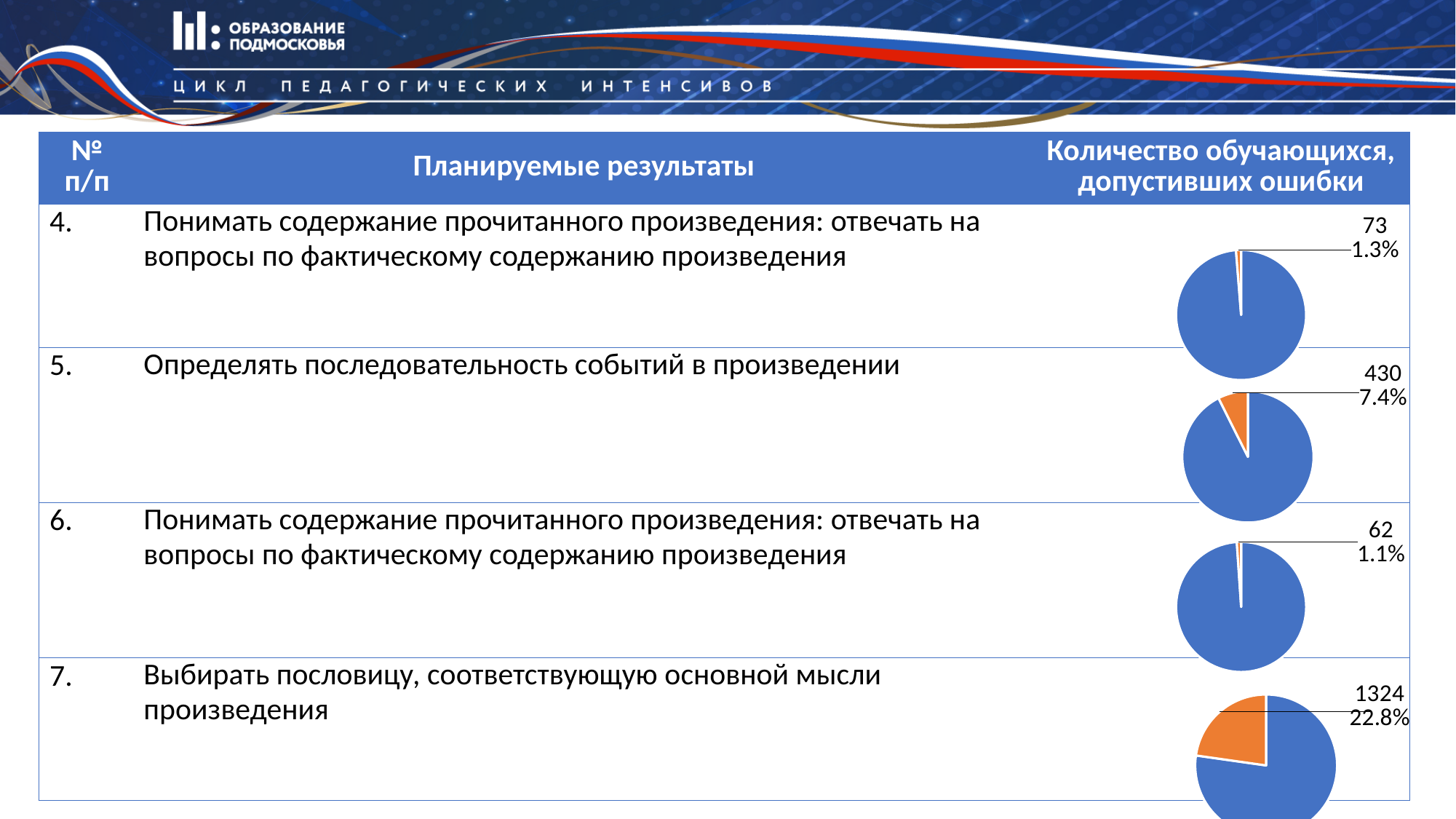
In the pie chart for row 5, what share of the pie is the orange slice? 7.4% In the pie chart for row 4 (Понимать содержание прочитанного произведения), how many students made errors according to the data label? 73 In the pie chart for row 7 (Выбирать пословицу, соответствующую основной мысли произведения), what number is shown on the data label? 1324 In the pie chart for row 5 (Определять последовательность событий в произведении), what number is shown on the data label? 430 In the pie chart for row 4, what percentage does the orange slice represent? 1.3% In the pie chart for row 6, how many students made errors according to the data label? 62 What type of chart is used in the right-hand column of the table? Pie chart In the pie chart for row 6, what percentage is shown for the orange slice? 1.1% What is the difference between the number of students with errors in row 7 and in row 5? 894 Which row's pie chart shows the smallest number of students who made errors? Row 6 (62) Which row's pie chart shows the largest number of students who made errors? Row 7 (1324)